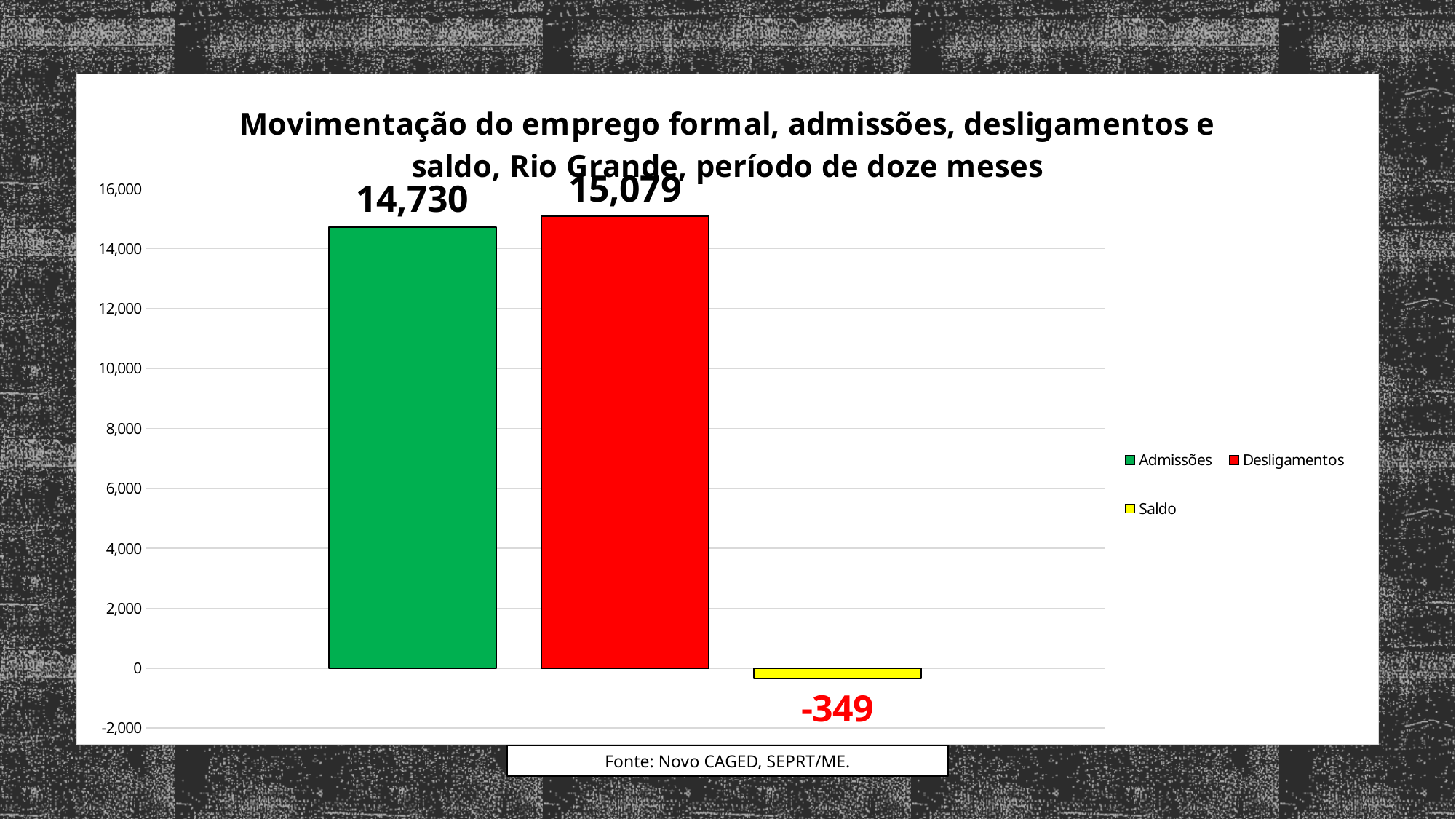
What is the value for Admissões? 14,730 What colour is the bar for Saldo? yellow How many series does the legend list? 3 What is the difference between Desligamentos and Admissões? 349 What is the value for Saldo? -349 Is the value for Admissões greater or less than 14,000? greater Which series has the highest value? Desligamentos What is the value for Desligamentos? 15,079 Which is larger, Admissões or Desligamentos? Desligamentos What kind of chart is shown? bar chart Which series has the lowest value? Saldo What source is cited below the chart? Novo CAGED, SEPRT/ME.